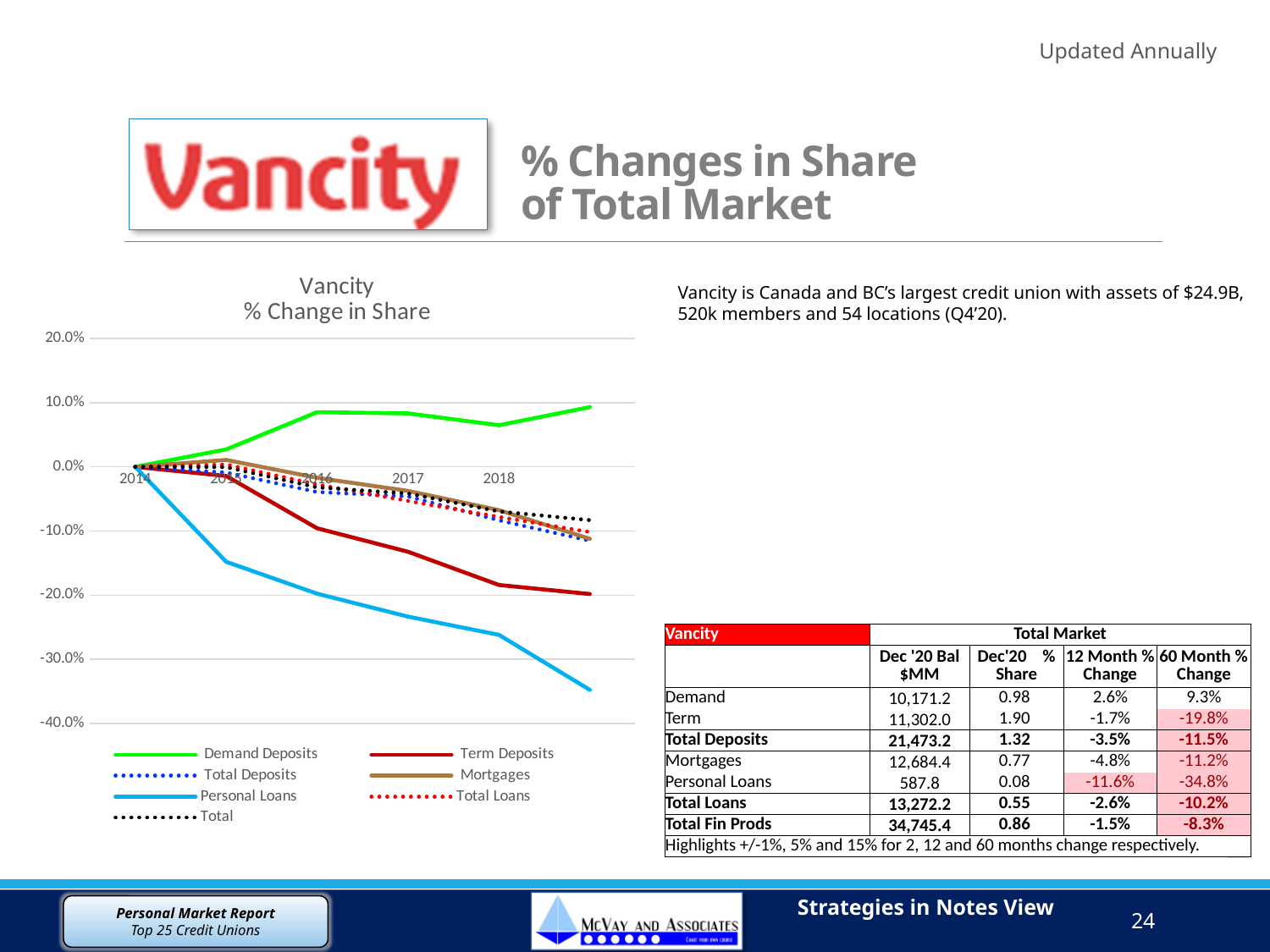
In the "Vancity % Change in Share" chart, which is larger in 2018: the value for Mortgages or the value for Term Deposits? Mortgages In the "Vancity % Change in Share" chart, does the Personal Loans line rise or fall from 2014 to the end of the chart? fall How many series does the legend of the "Vancity % Change in Share" chart list? 7 What kind of chart is the "Vancity % Change in Share" chart? line chart In the "Vancity % Change in Share" chart, is the final value for Personal Loans greater or less than -30.0%? less In the "Vancity % Change in Share" chart, which series has the highest value at the right end of the chart? Demand Deposits What colour is the Demand Deposits line in the "Vancity % Change in Share" chart? green In the "Vancity % Change in Share" chart, is the value for Term Deposits in 2018 greater or less than -10.0%? less In the "Vancity % Change in Share" chart, is the final value for Demand Deposits greater or less than 0.0%? greater In the "Vancity % Change in Share" chart, does the Demand Deposits line rise or fall overall from 2014 to the end of the chart? rise What is the highest tick value shown on the y axis of the "Vancity % Change in Share" chart? 20.0% In the "Vancity % Change in Share" chart, which series has the lowest value at the right end of the chart? Personal Loans